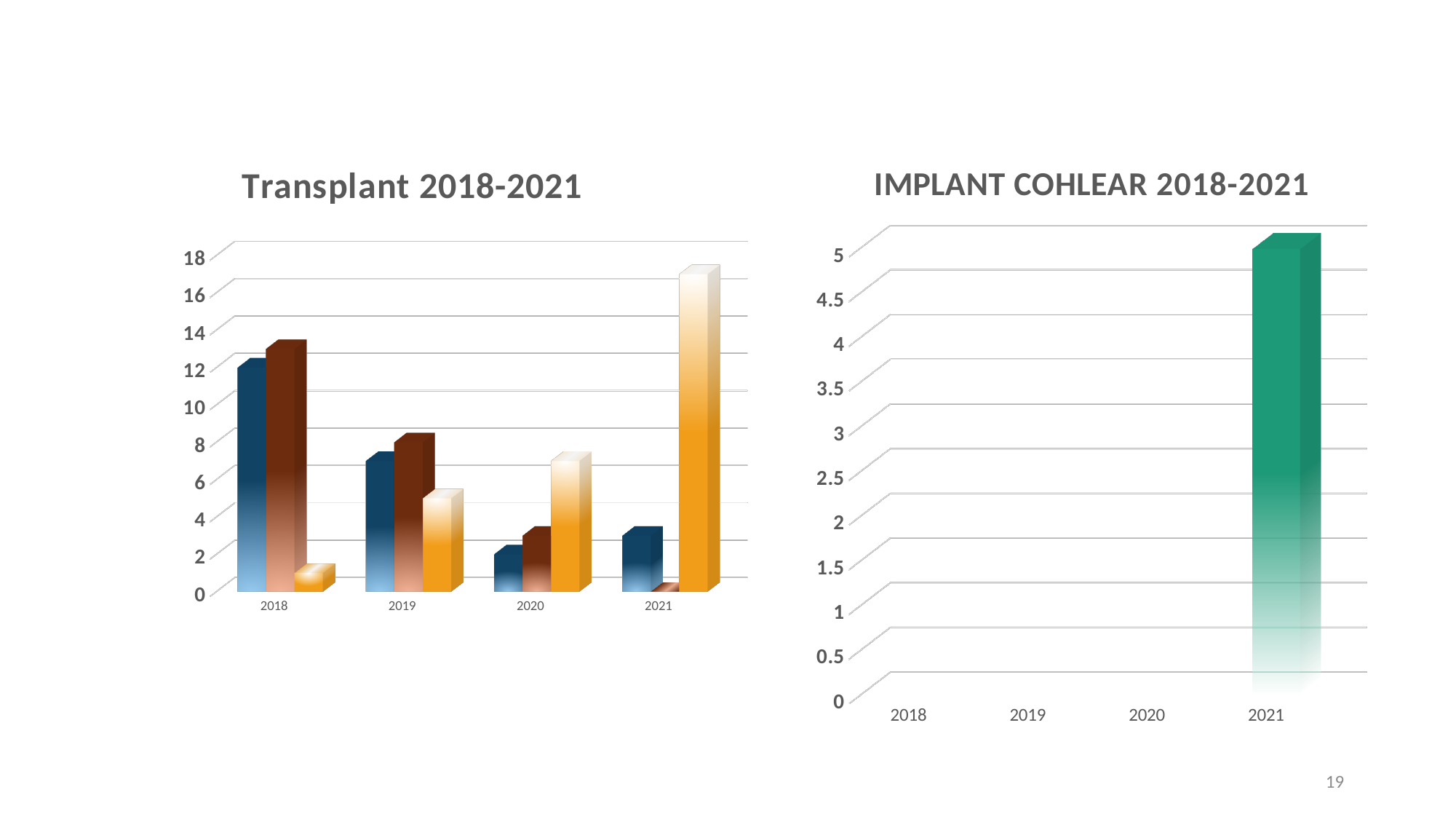
How many years are shown on the x axis of the Transplant 2018-2021 chart? 4 In the Transplant 2018-2021 chart, which year contains the tallest bar? 2021 What is the title of the chart on the right side of the slide? IMPLANT COHLEAR 2018-2021 In the IMPLANT COHLEAR 2018-2021 chart, is the value for 2021 greater or less than 4? greater How many years are shown on the x axis of the IMPLANT COHLEAR 2018-2021 chart? 4 In the Transplant 2018-2021 chart, is the blue bar for 2020 greater or less than 4? less What kind of chart is the IMPLANT COHLEAR 2018-2021 chart? bar chart In the Transplant 2018-2021 chart, do the orange bars rise or fall from 2018 to 2021? rise In the IMPLANT COHLEAR 2018-2021 chart, which year has the highest bar? 2021 In the IMPLANT COHLEAR 2018-2021 chart, how many years have a visible bar? 1 In the Transplant 2018-2021 chart, is the tallest bar for 2021 greater or less than 14? greater What kind of chart is the Transplant 2018-2021 chart? bar chart